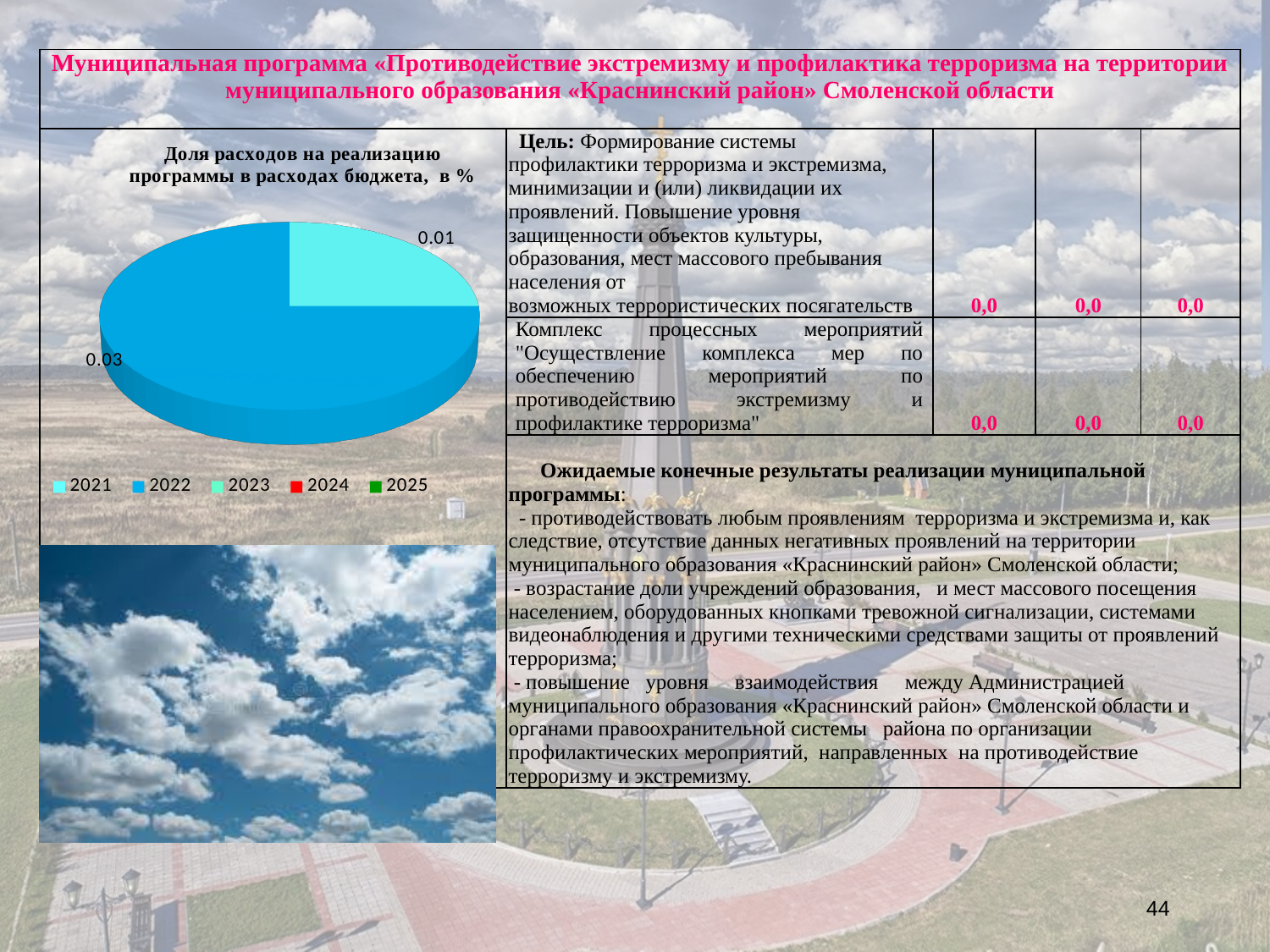
What is the title of the pie chart? Доля расходов на реализацию программы в расходах бюджета, в % How many entries does the legend of the pie chart list? 5 How many slices with data labels are visible in the pie chart? 2 What colour is the slice for 2022 in the pie chart? blue Which year has the larger slice in the pie chart, 2021 or 2022? 2022 What kind of chart is shown on the slide? pie chart What value is labelled on the pie slice for 2022? 0.03 What is the difference between the labelled values for 2022 and 2021? 0.02 Which year has the largest slice in the pie chart? 2022 What value is labelled on the pie slice for 2021? 0.01